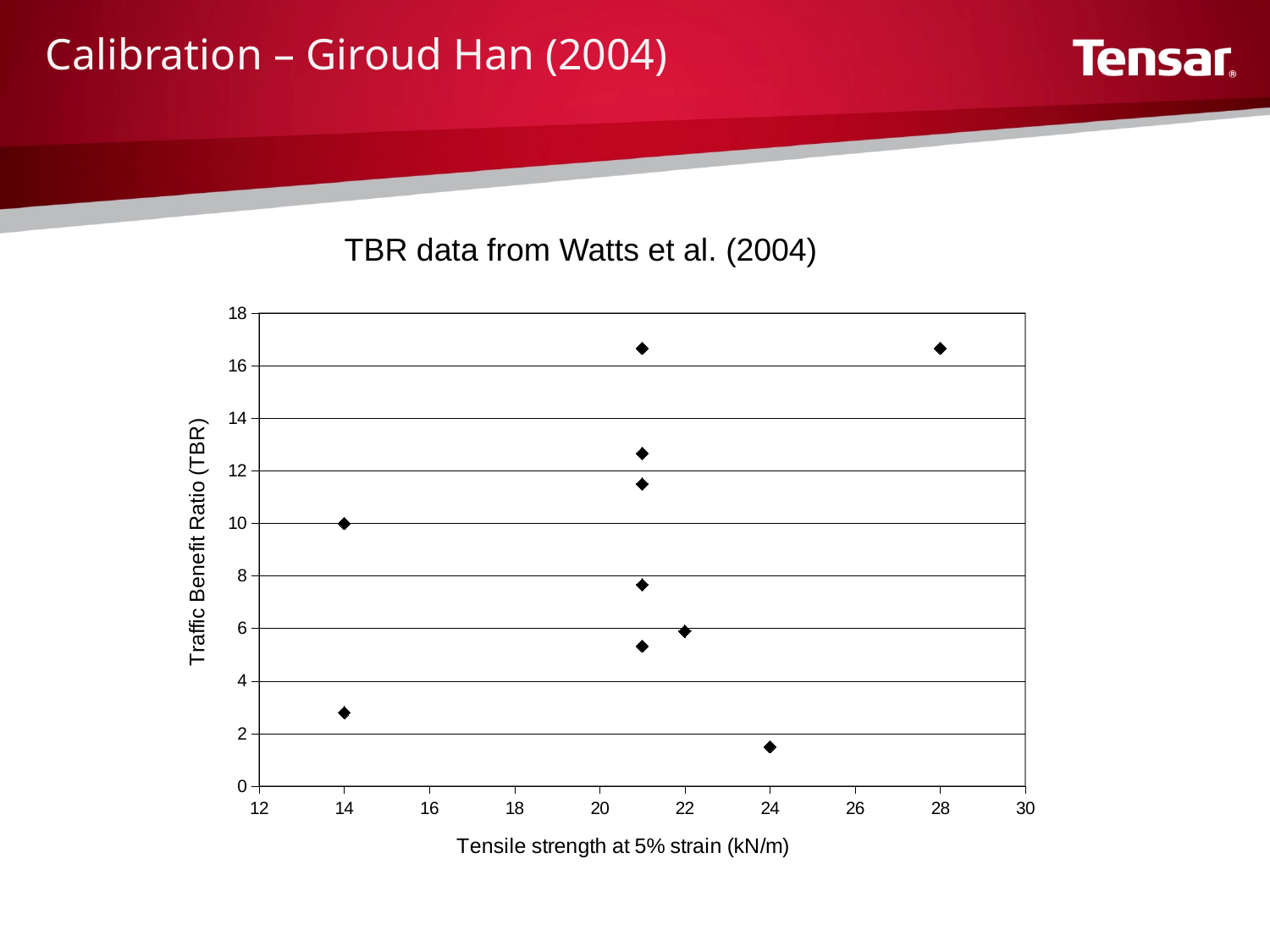
What is the largest tensile strength value at which a point is plotted? 28 What kind of chart is shown on the slide? scatter chart At which tensile strength is the lowest TBR value plotted? 24 Is the TBR value for the lower point at a tensile strength of 14 kN/m greater or less than 4? less Is the TBR value for the point at a tensile strength of 22 kN/m greater or less than 4? greater Is the TBR value for the point at a tensile strength of 28 kN/m greater or less than 16? greater How many data points are plotted at a tensile strength of 21 kN/m? 5 Which has the larger TBR: the point at 22 kN/m or the point at 24 kN/m? 22 kN/m What is the title of the chart? TBR data from Watts et al. (2004) What is the label of the x axis? Tensile strength at 5% strain (kN/m) How many data points are plotted on the chart? 10